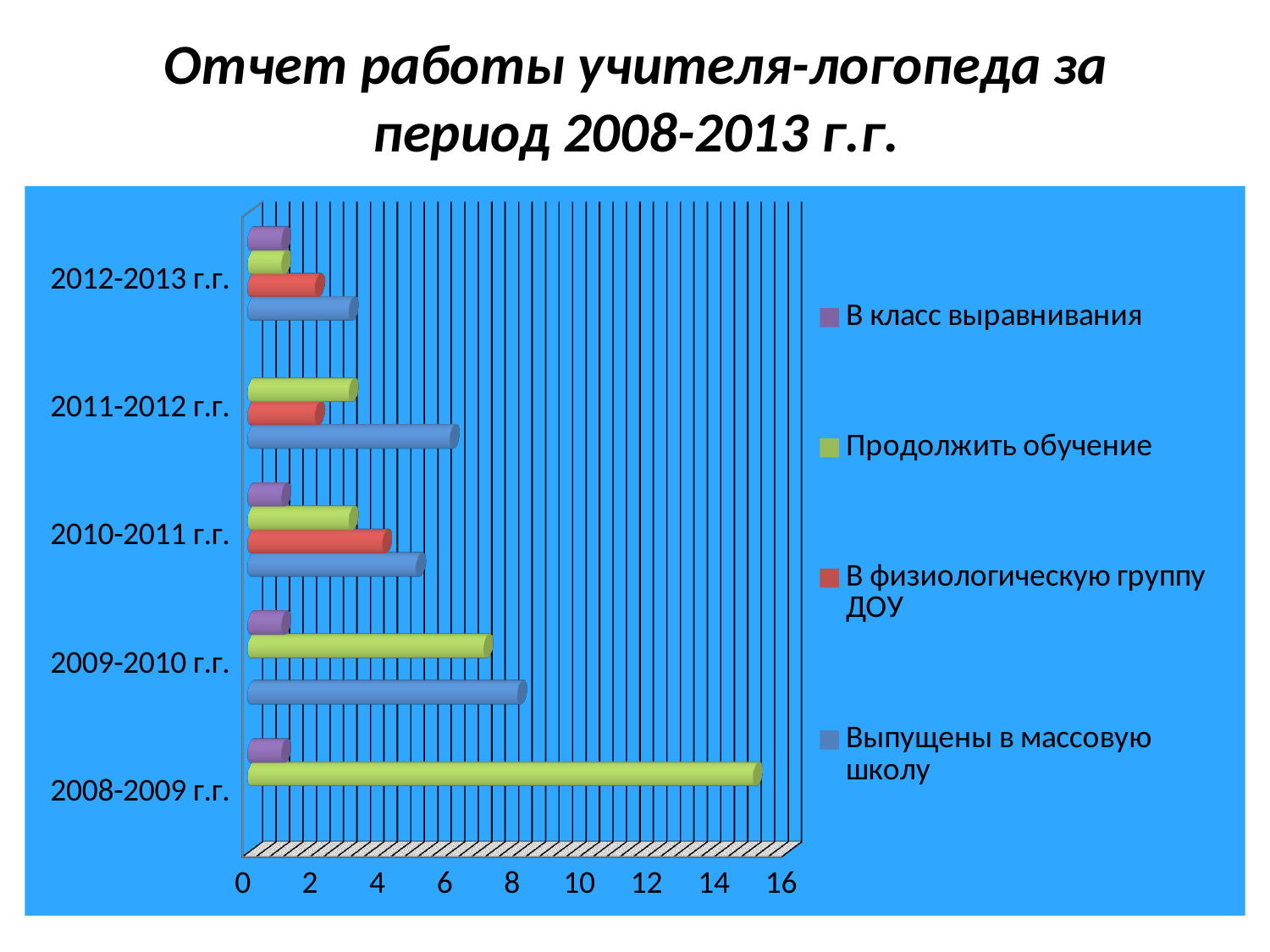
How many series does the legend list? 4 In 2011-2012 г.г., which is larger: "Выпущены в массовую школу" or "В физиологическую группу ДОУ"? Выпущены в массовую школу Is the value for "Выпущены в массовую школу" in 2009-2010 г.г. greater or less than 6? greater Does the value for "Продолжить обучение" rise or fall from 2008-2009 г.г. to 2012-2013 г.г.? fall Is the value for "Продолжить обучение" in 2008-2009 г.г. greater or less than 14? greater What is the title of the slide? Отчет работы учителя-логопеда за период 2008-2013 г.г. What colour represents "В физиологическую группу ДОУ" in the legend? red Which period has the highest value for "Продолжить обучение"? 2008-2009 г.г. How many periods (categories) are shown on the vertical axis? 5 Which period has the highest value for "Выпущены в массовую школу"? 2009-2010 г.г. What kind of chart is shown on the slide? bar chart Is the value for "В физиологическую группу ДОУ" in 2010-2011 г.г. greater or less than 2? greater